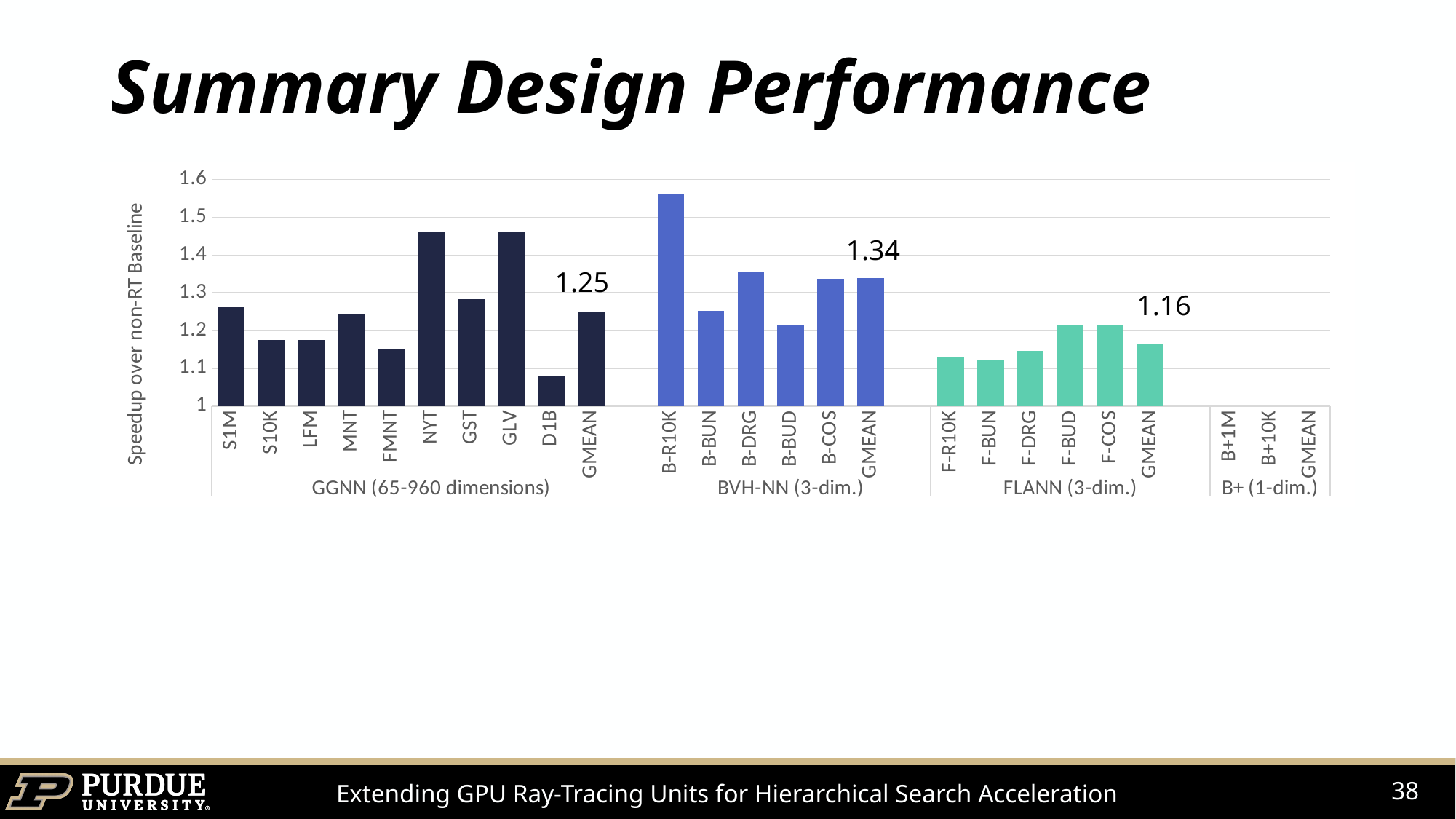
What is the GMEAN speedup shown for the BVH-NN (3-dim.) group? 1.34 What is the GMEAN speedup shown for the FLANN (3-dim.) group? 1.16 What is the difference between the BVH-NN GMEAN and the FLANN GMEAN? 0.18 How many bars are plotted in the GGNN (65-960 dimensions) group, including GMEAN? 10 What is the label of the y axis? Speedup over non-RT Baseline Is the speedup for B-R10K greater or less than 1.5? greater Which benchmark in the GGNN group has the lowest speedup? D1B What is the GMEAN speedup shown for the GGNN (65-960 dimensions) group? 1.25 What is the difference between the BVH-NN GMEAN and the GGNN GMEAN? 0.09 Is the speedup for D1B greater or less than 1.1? less Which benchmark has the highest speedup bar on the chart? B-R10K Which is larger, the speedup for B-R10K or for NYT? B-R10K